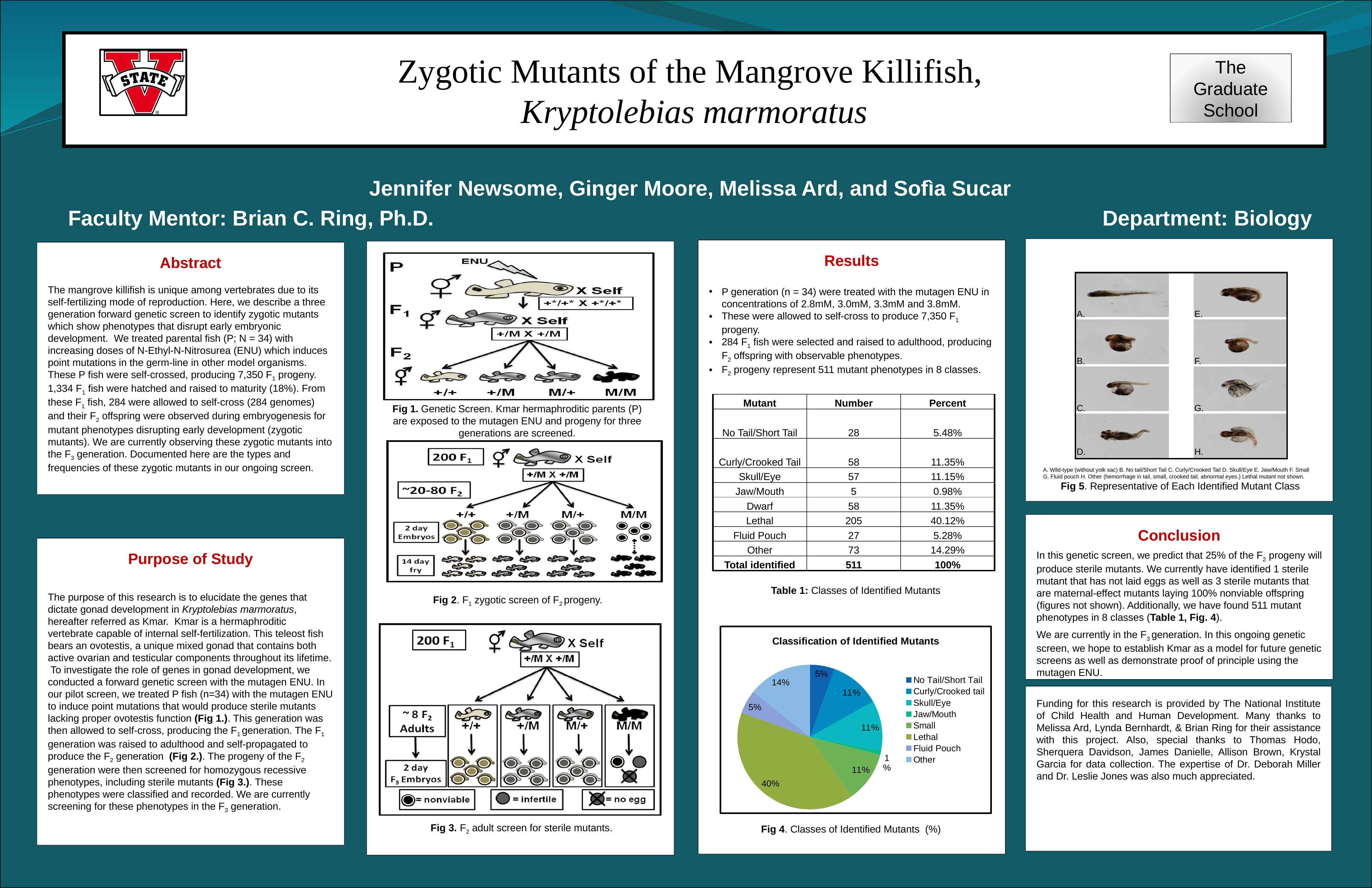
What percentage does the pie chart show for Lethal? 40% How many entries does the legend of the pie chart list? 8 What percentage does the pie chart show for Fluid Pouch? 5% In the pie chart, which slice is larger: Other or Skull/Eye? Other In the pie chart, how many percentage points larger is the Lethal slice than the Other slice? 26 What percentage does the pie chart show for Jaw/Mouth? 1% How many slices does the pie chart have? 8 What percentage does the pie chart show for Other? 14% What is the title of the pie chart? Classification of Identified Mutants What kind of chart is shown under the title "Classification of Identified Mutants"? pie chart Which category has the smallest slice in the pie chart? Jaw/Mouth Which category has the largest slice in the pie chart? Lethal